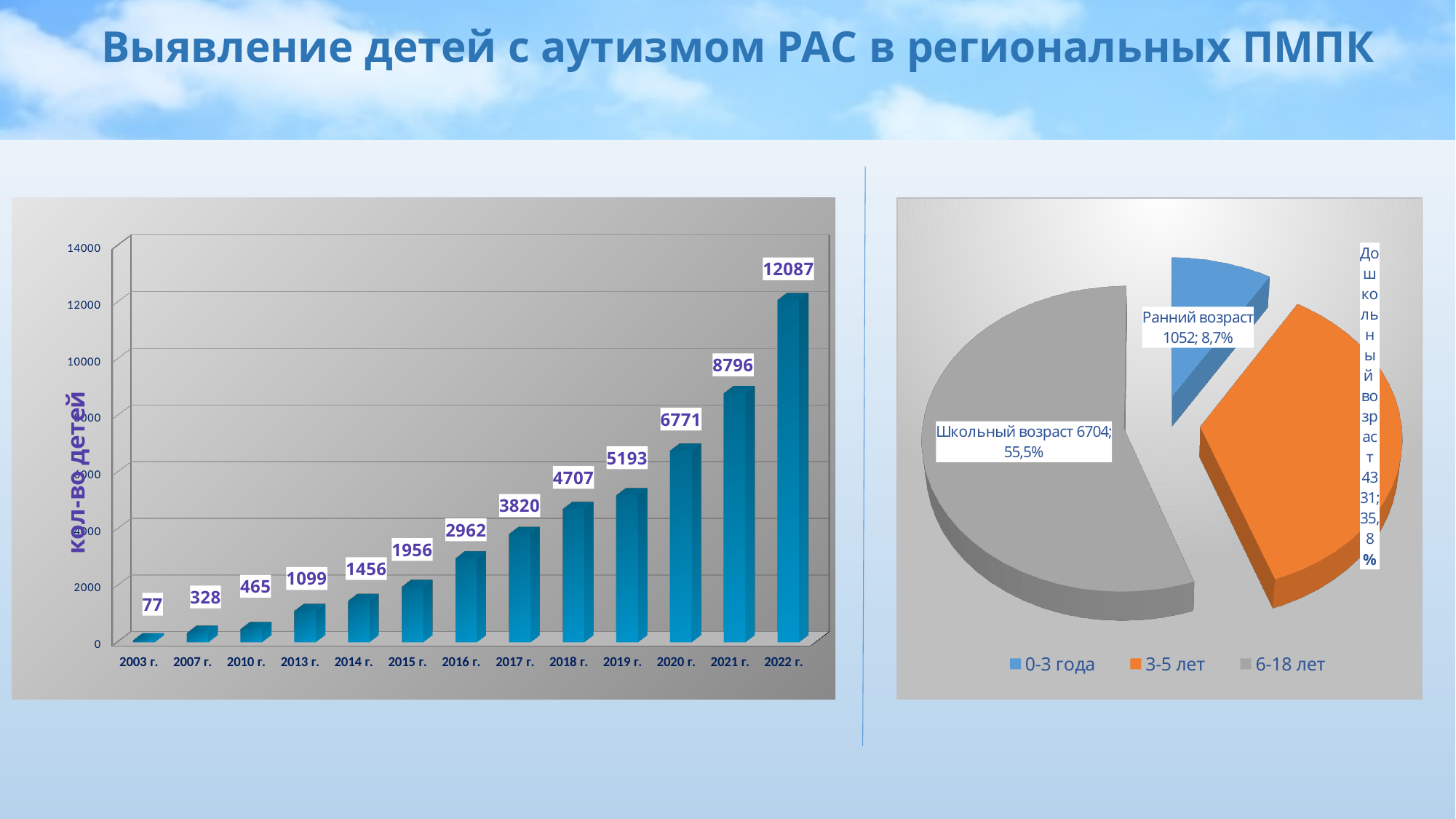
In the pie chart on the right, what is the value for Ранний возраст? 1052 Do the values in the bar chart on the left rise or fall from 2003 г. to 2022 г.? rise In the bar chart on the left, what is the value for 2013 г.? 1099 In the bar chart on the left, which year has the highest value? 2022 г. How many entries does the legend of the pie chart on the right list? 3 In the bar chart on the left, what is the difference between the values for 2022 г. and 2021 г.? 3291 In the bar chart on the left, which is larger: the value for 2018 г. or the value for 2019 г.? 2019 г. In the bar chart on the left, what is the value for 2022 г.? 12087 In the pie chart on the right, what share does Школьный возраст have? 55,5% In the bar chart on the left, which year has the lowest value? 2003 г. What type of chart is the chart on the left? bar chart How many years are shown on the x axis of the bar chart on the left? 13